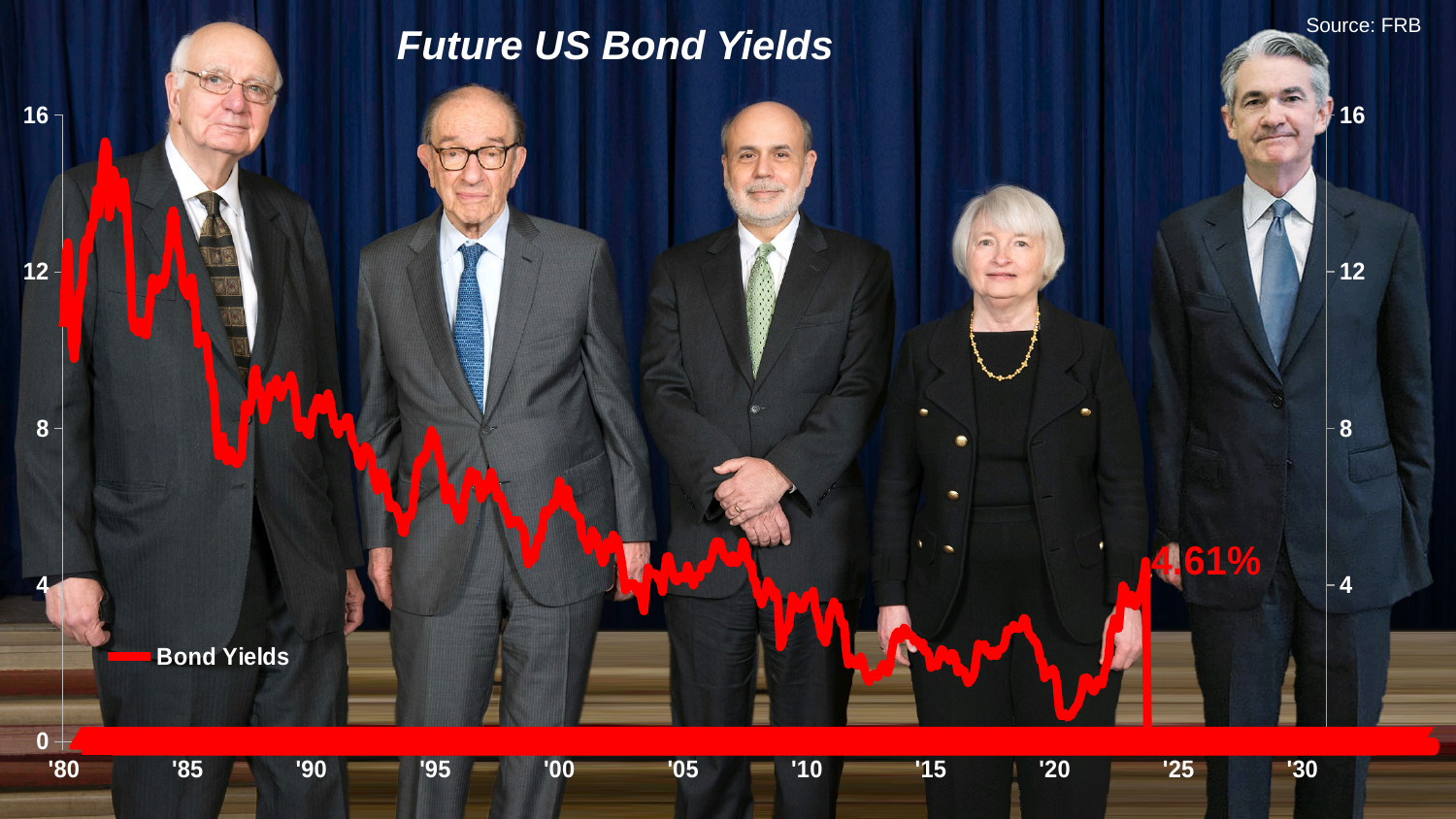
How many series does the legend list? 1 Which is larger, the bond yield at '85 or the bond yield at '15? '85 Overall, do bond yields rise or fall from '80 to '20 along the x axis? fall Is the peak value of the Bond Yields line greater or less than 12? greater What value is printed as the data label at the end of the Bond Yields line? 4.61% What kind of chart is shown on the slide? line chart Is the value of the Bond Yields line at '85 greater or less than 8? greater Is the value of the Bond Yields line at '00 greater or less than 4? greater How many year labels are shown on the x axis? 11 What is the title of the chart? Future US Bond Yields What is the name of the series shown in the legend? Bond Yields